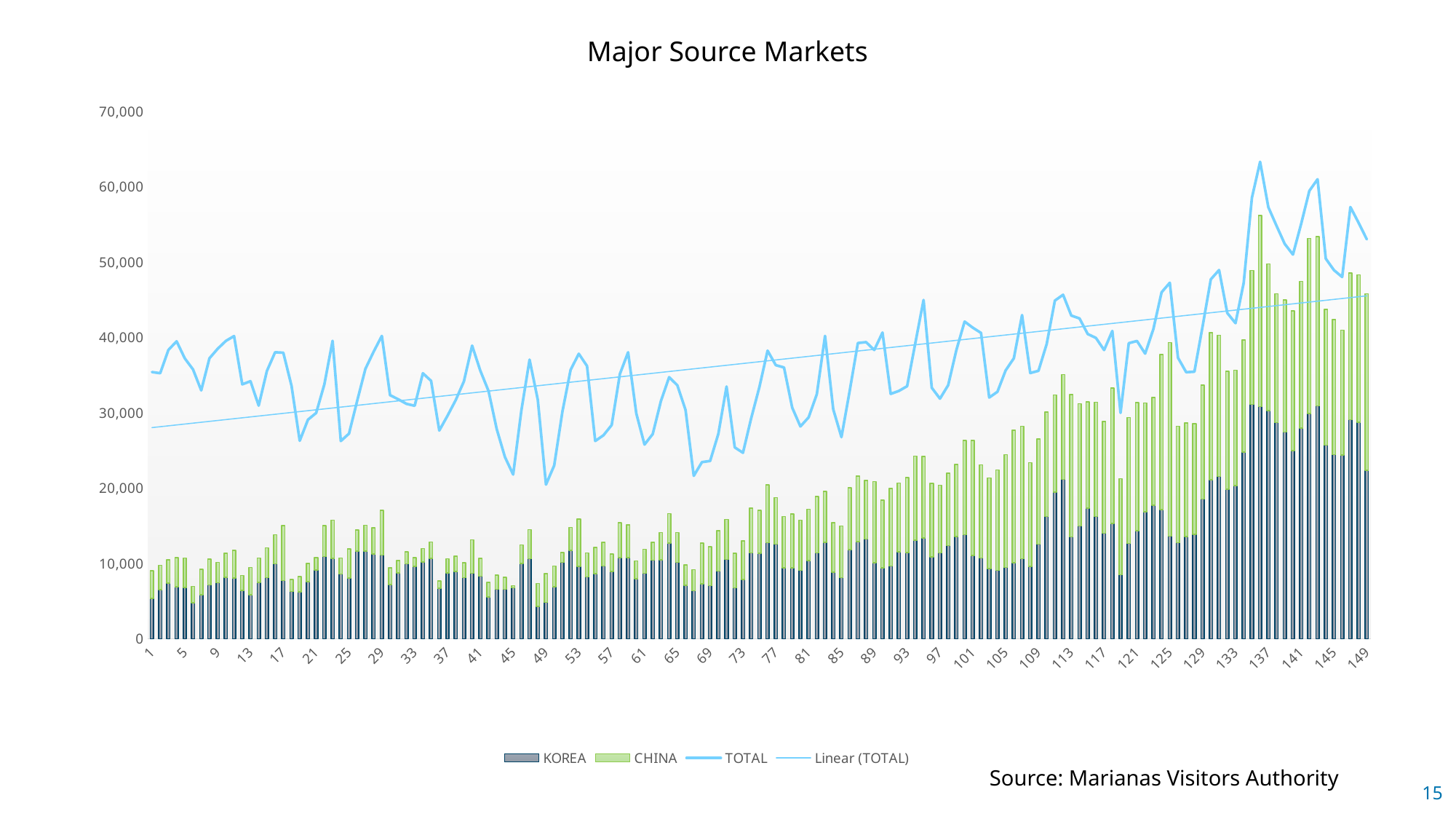
Does the Linear (TOTAL) trendline rise or fall from left to right? Rises What is the highest value shown on the vertical axis? 70,000 How many entries does the chart's legend list? 4 Is the KOREA value at point 1 greater or less than 10,000? less Is the TOTAL value at point 49 greater or less than 30,000? less Which series is drawn in green in the chart? CHINA What is the title of the chart? Major Source Markets Which is larger, the KOREA value at point 1 or the KOREA value at point 149? Point 149 What kind of chart is used to show the KOREA and CHINA series? Stacked bar chart At point 137, which is larger, the KOREA segment or the CHINA segment? KOREA Is the TOTAL value at point 1 greater or less than 30,000? greater